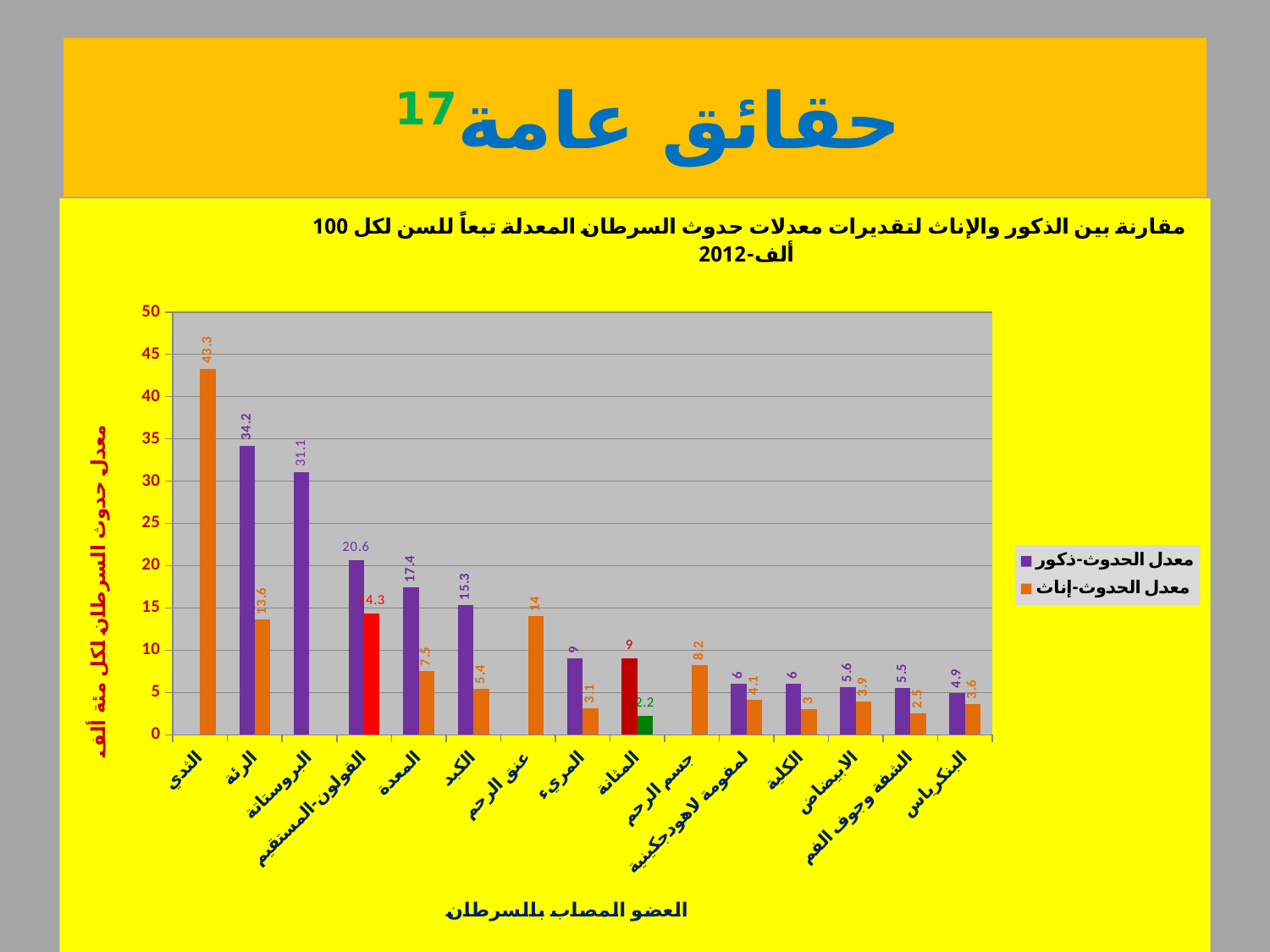
What is the female incidence rate (معدل الحدوث-إناث) for الثدي (breast)? 43.3 What is the male incidence rate (معدل الحدوث-ذكور) for الرئة (lung)? 34.2 What is the y-axis label of the chart? معدل حدوث السرطان لكل مئة ألف What is the difference between the male and female incidence rates for المعدة (stomach)? 9.9 What kind of chart is shown on the slide? Bar chart How many cancer site categories are shown on the x axis? 15 Is the male incidence rate for الكبد (liver) greater or less than 10? greater How many series does the legend list? 2 What is the female incidence rate for القولون-المستقيم (colon-rectum)? 14.3 Which is larger: the male incidence rate for البروستاتة (prostate) or the female incidence rate for الثدي (breast)? الثدي (female) Which category has the lowest male incidence rate? البنكرياس Which category has the highest male incidence rate? الرئة